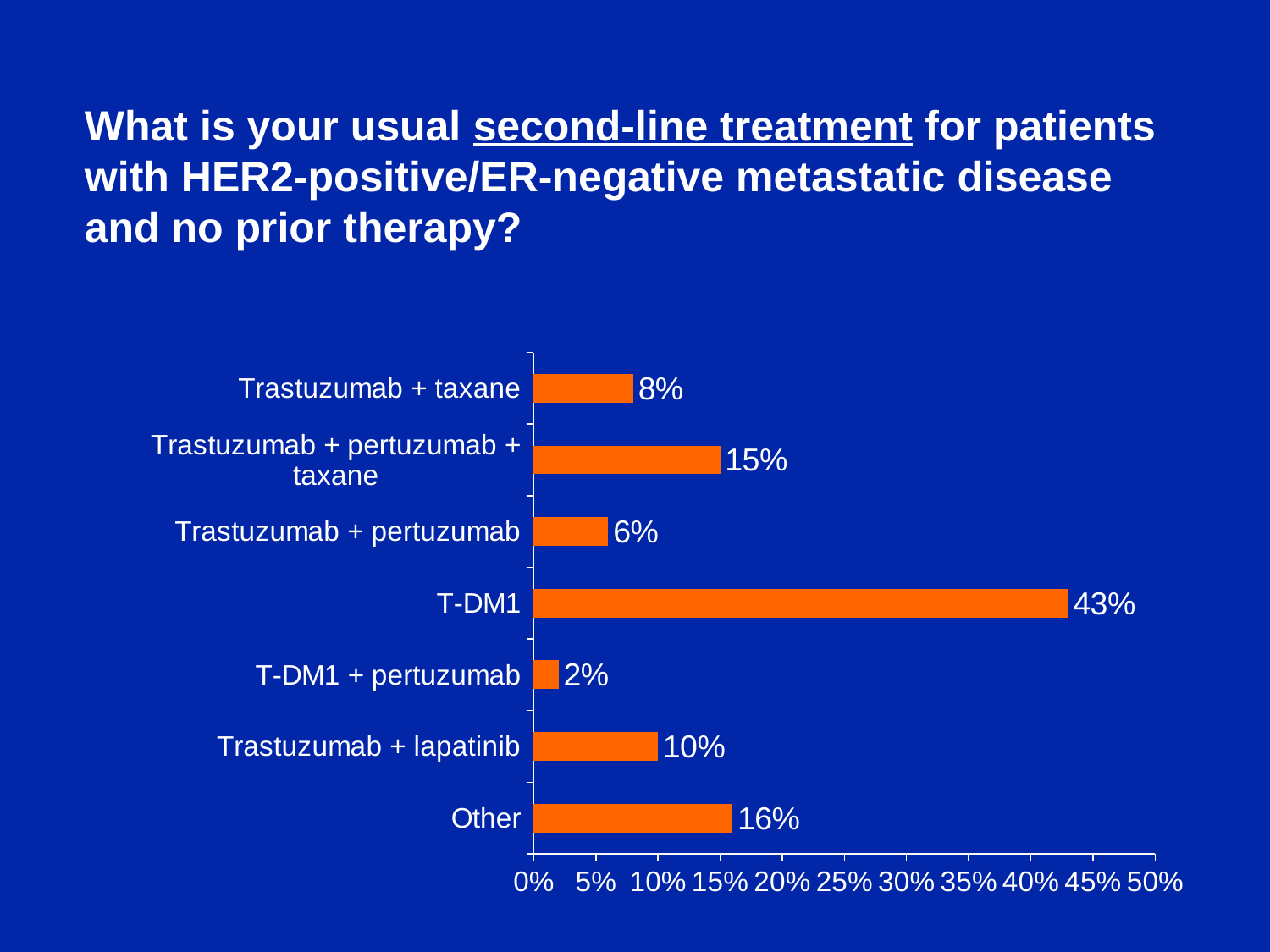
Which treatment option has the highest percentage? T-DM1 Is the value for T-DM1 greater or less than 40%? greater What is the value shown for Trastuzumab + pertuzumab + taxane? 15% What kind of chart is shown on the slide? Bar chart What is the difference in percentage points between Trastuzumab + taxane and Trastuzumab + pertuzumab? 2 Which has a larger value, Trastuzumab + pertuzumab + taxane or Trastuzumab + lapatinib? Trastuzumab + pertuzumab + taxane What percentage of respondents chose T-DM1 as their usual second-line treatment? 43% What is the difference in percentage points between T-DM1 and Other? 27 Which treatment option has the lowest percentage? T-DM1 + pertuzumab How many treatment options are shown in the chart? 7 What is the value shown for Other? 16% What is the value shown for Trastuzumab + lapatinib? 10%